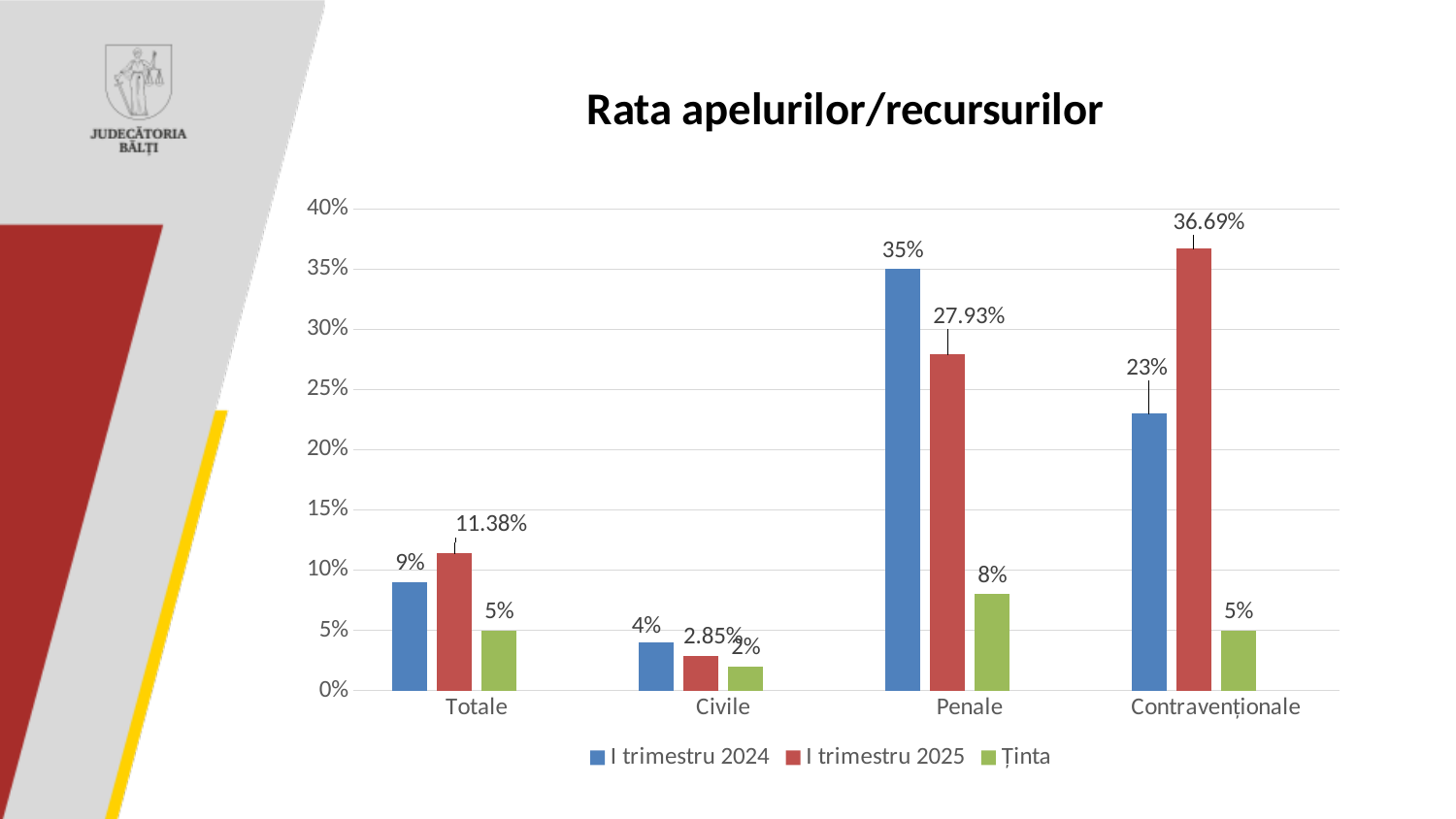
Which category has the lowest value in the I trimestru 2024 series? Civile What is the title of the chart? Rata apelurilor/recursurilor What is the Ținta value for Penale? 8% What is the difference between the I trimestru 2025 and I trimestru 2024 values for Contravenționale? 13.69% What is the value for Civile in the I trimestru 2025 series? 2.85% Which category has the highest value in the I trimestru 2025 series? Contravenționale What is the value for Contravenționale in the I trimestru 2025 series? 36.69% How many categories are shown on the x axis? 4 How many series does the legend list? 3 What is the value for Penale in the I trimestru 2024 series? 35% For Totale, which is larger: the I trimestru 2024 value or the I trimestru 2025 value? I trimestru 2025 What is the difference between the I trimestru 2024 and I trimestru 2025 values for Penale? 7.07%